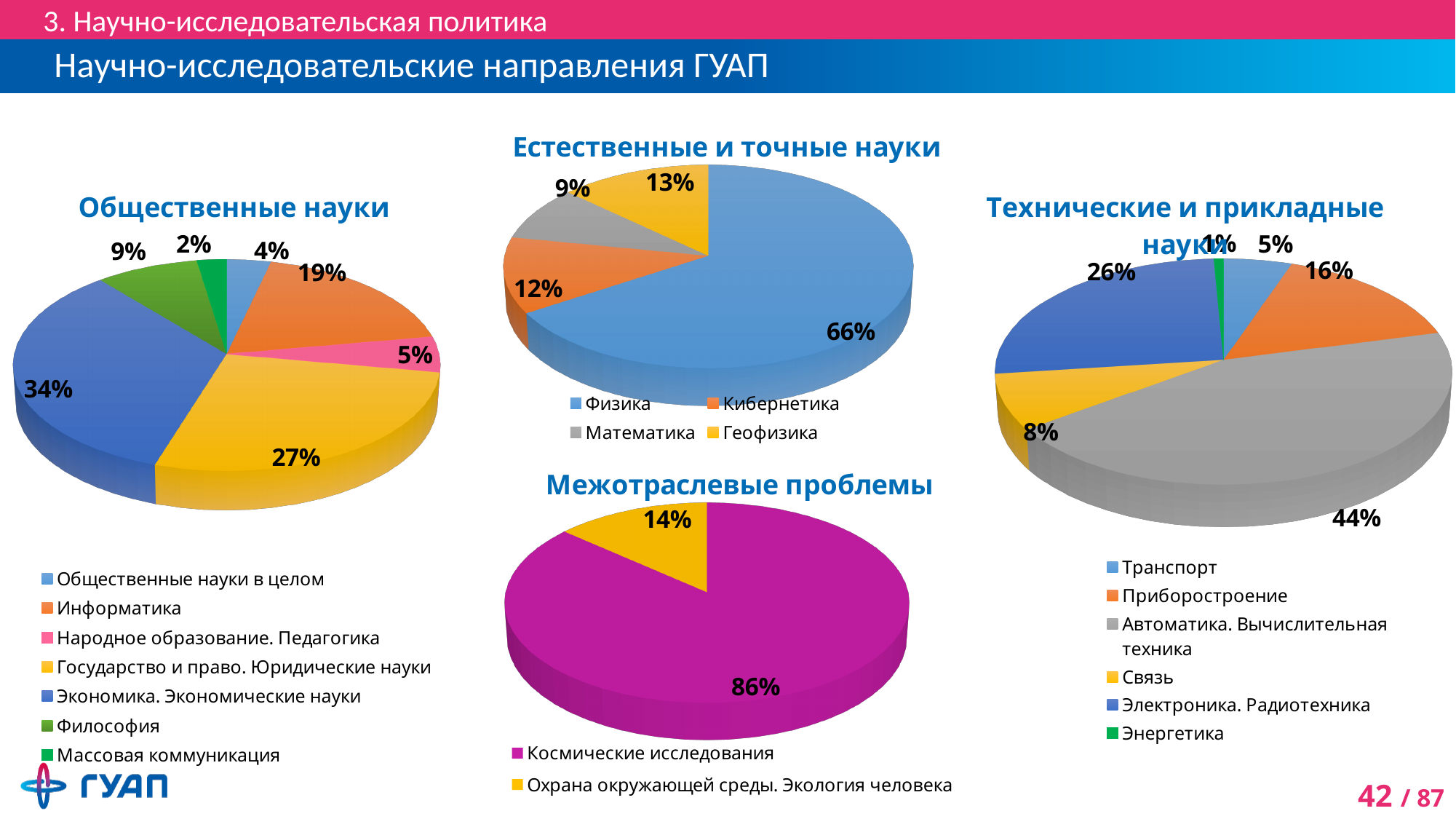
In the 'Межотраслевые проблемы' chart, what share does 'Охрана окружающей среды. Экология человека' have? 14% What kind of chart is 'Межотраслевые проблемы'? Pie chart In the 'Технические и прикладные науки' chart, what is the difference between the shares of 'Приборостроение' and 'Связь'? 8% In the 'Естественные и точные науки' chart, what is the difference between the shares of 'Геофизика' and 'Математика'? 4% In the 'Общественные науки' chart, how many categories does the legend list? 7 In the 'Технические и прикладные науки' chart, which category has the largest share? Автоматика. Вычислительная техника In the 'Технические и прикладные науки' chart, what share does 'Электроника. Радиотехника' have? 26% In the 'Естественные и точные науки' chart, what share does 'Физика' have? 66% In the 'Общественные науки' chart, which category has the smallest share? Массовая коммуникация How many pie charts are shown on the slide? 4 In the 'Естественные и точные науки' chart, which is larger: 'Кибернетика' or 'Геофизика'? Геофизика